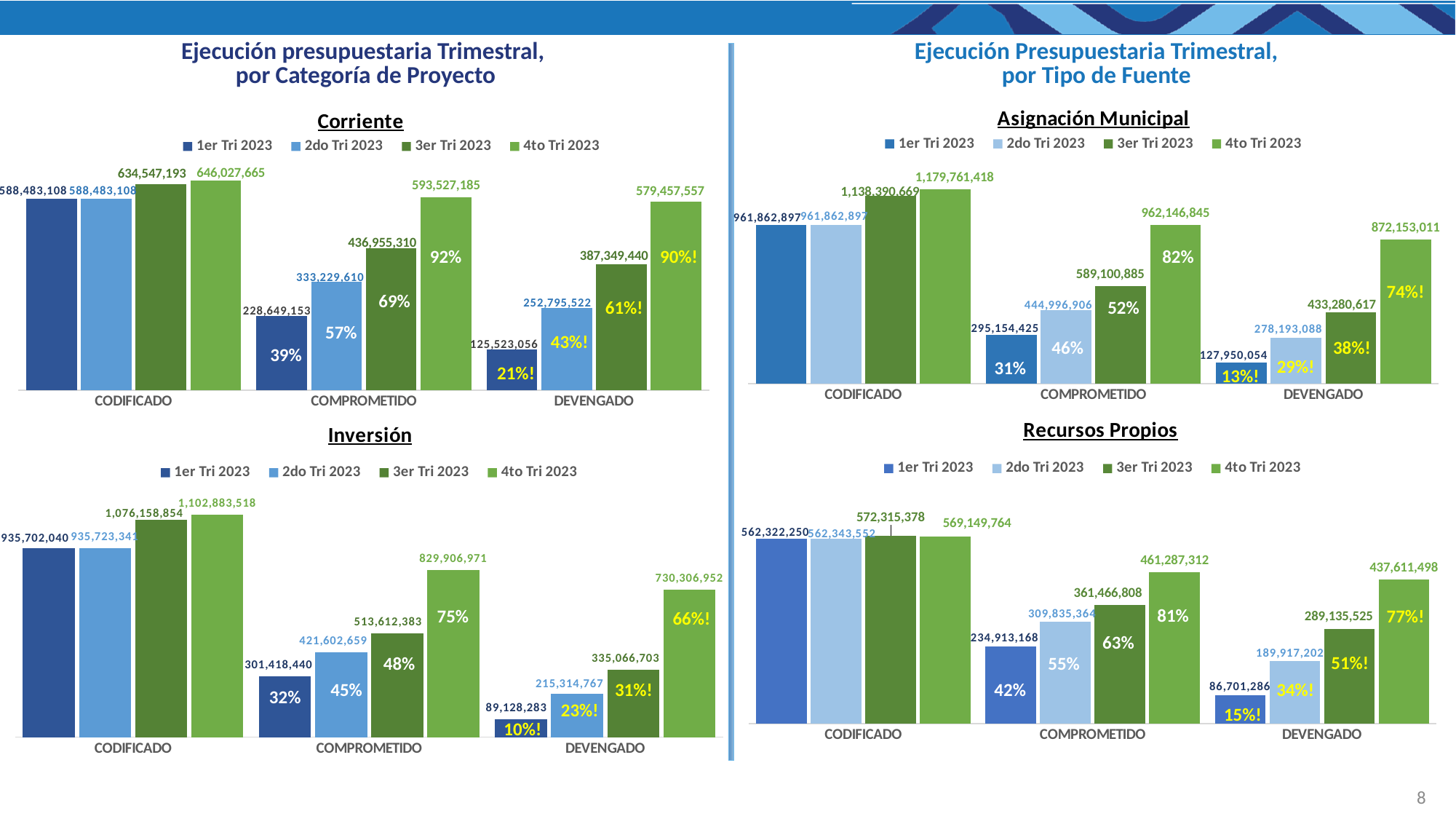
In the Inversión chart, what is the value for 1er Tri 2023 in the DEVENGADO category? 89,128,283 In the Asignación Municipal chart, which is larger: the 4to Tri 2023 value for COMPROMETIDO or the 4to Tri 2023 value for DEVENGADO? COMPROMETIDO In the Asignación Municipal chart, what is the value for 3er Tri 2023 in the COMPROMETIDO category? 589,100,885 In the Corriente chart, what is the value for 4to Tri 2023 in the DEVENGADO category? 579,457,557 How many categories are shown on the x axis of the Inversión chart? 3 In the Recursos Propios chart, what is the value for 2do Tri 2023 in the DEVENGADO category? 189,917,202 In the Recursos Propios chart, which series has the lowest value in the DEVENGADO category? 1er Tri 2023 How many series does the legend of the Recursos Propios chart list? 4 In the Inversión chart, what is the difference between the 4to Tri 2023 and 3er Tri 2023 values in the COMPROMETIDO category? 316,294,588 What type of chart is the Asignación Municipal chart? Bar chart In the Corriente chart, what is the difference between the 4to Tri 2023 and 1er Tri 2023 values in the DEVENGADO category? 453,934,501 In the Corriente chart, which series has the highest value in the COMPROMETIDO category? 4to Tri 2023